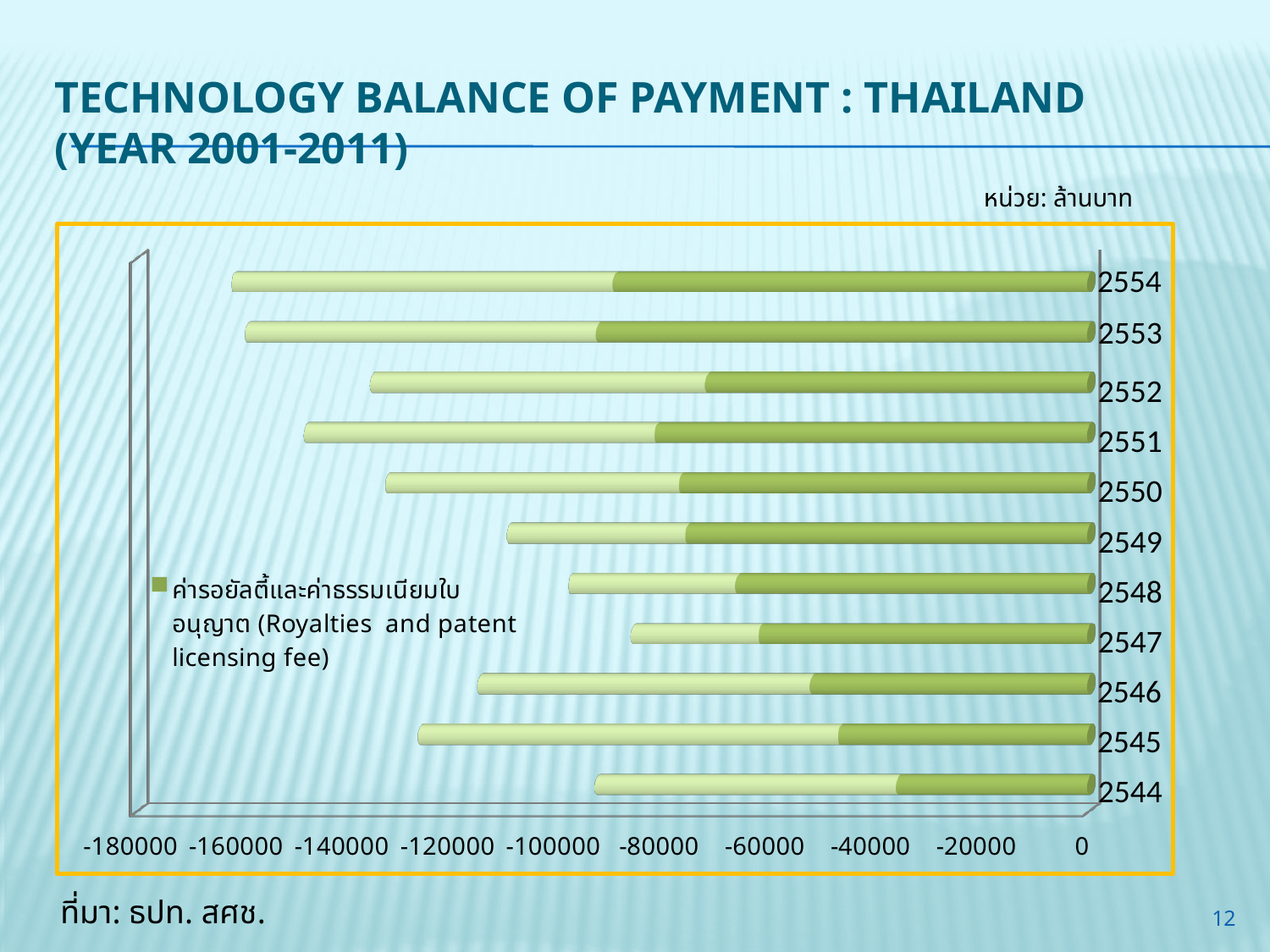
Is the value for 2554 greater or less than -140000? less How many years (categories) are plotted on the chart? 11 Which bar extends further from zero, 2551 or 2547? 2551 Which bar extends further from zero, 2554 or 2544? 2554 Which year's bar is the shortest (closest to zero)? 2547 Is the value for 2547 greater or less than -100000? greater What kind of chart is shown on the slide? bar chart How many series does the chart's legend list? 1 What unit is stated above the chart? ล้านบาท Is the value for 2552 greater or less than -120000? less